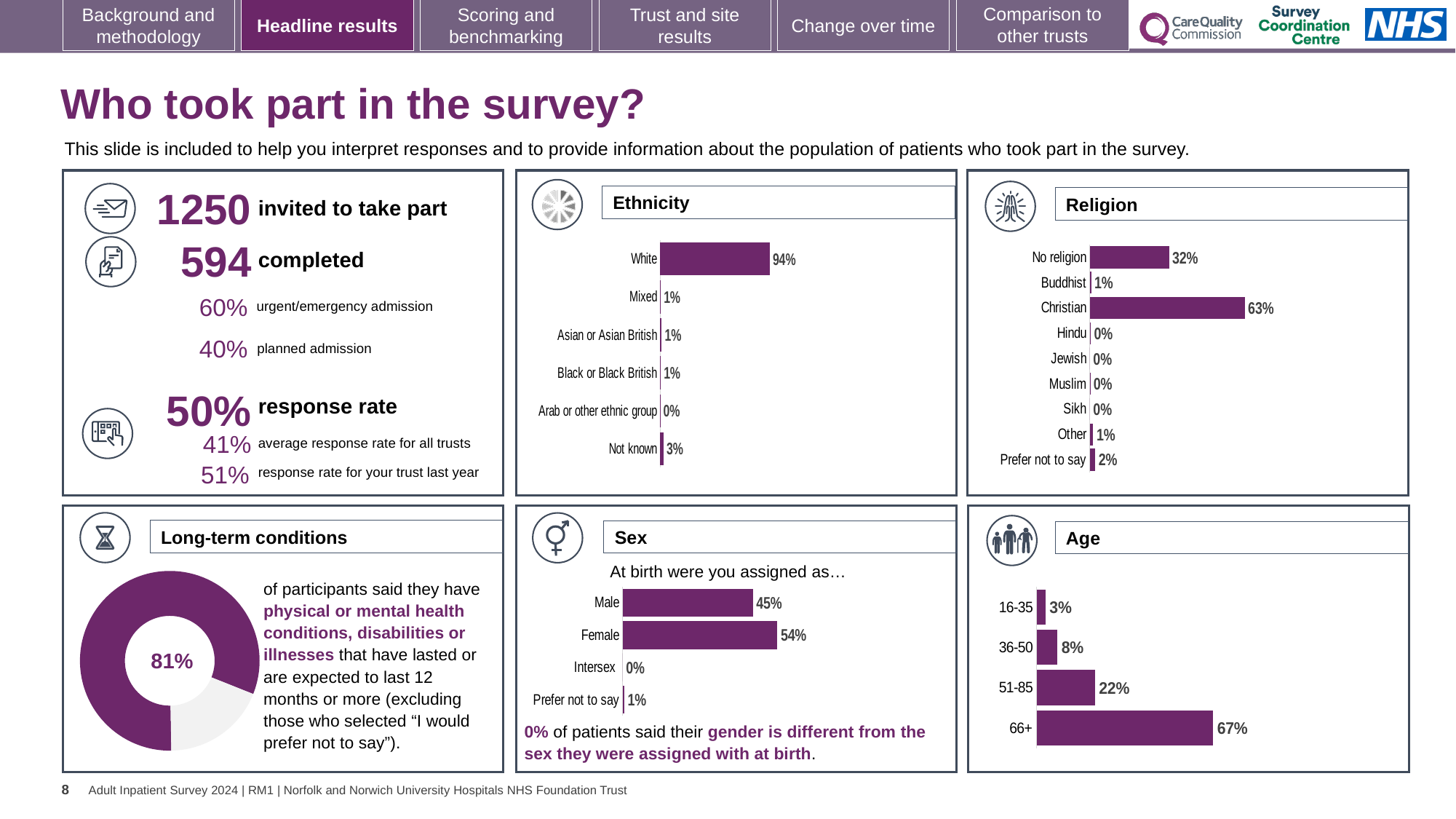
In the Age chart, do the values rise or fall as the age groups increase from 16-35 to 66+? rise In the Ethnicity chart, what percentage of respondents are recorded as Not known? 3% In the Religion chart, how many categories are shown? 9 In the Sex chart, what is the difference between the Female and Male percentages? 9% In the Ethnicity chart, what percentage of respondents are White? 94% In the Religion chart, which category has the highest value? Christian What kind of chart is used in the Long-term conditions panel? doughnut chart In the Sex chart, which is larger, Male or Female? Female In the Religion chart, what percentage of respondents have no religion? 32% In the Religion chart, what is the difference between the Christian and No religion percentages? 31% In the Age chart, which age group has the highest value? 66+ In the Age chart, what percentage of respondents are aged 51-85? 22%